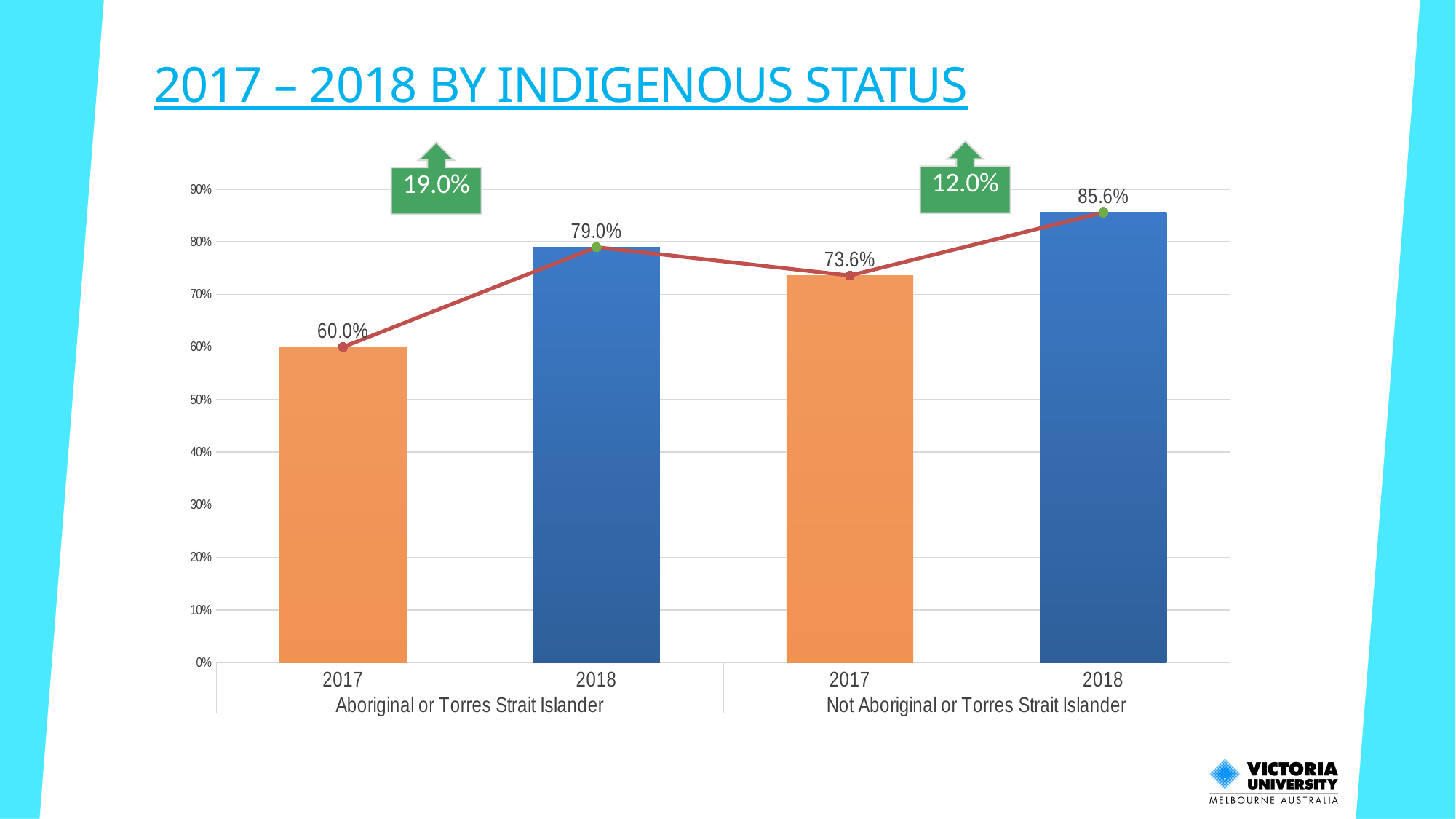
Which bar has the highest value? 2018, Not Aboriginal or Torres Strait Islander Which is larger: the 2018 value for Aboriginal or Torres Strait Islander or the 2017 value for Not Aboriginal or Torres Strait Islander? 2018 Aboriginal or Torres Strait Islander What is the difference between the 2018 and 2017 values for the Not Aboriginal or Torres Strait Islander group? 12.0% What kind of chart is shown on the slide? Bar chart with a line overlay How many bars are plotted on the chart? 4 What is the title of the slide? 2017 – 2018 BY INDIGENOUS STATUS Which bar has the lowest value? 2017, Aboriginal or Torres Strait Islander What is the value for 2017 in the Not Aboriginal or Torres Strait Islander group? 73.6% What is the difference between the 2018 and 2017 values for the Aboriginal or Torres Strait Islander group? 19.0% What is the value for 2017 in the Aboriginal or Torres Strait Islander group? 60.0% What is the value for 2018 in the Aboriginal or Torres Strait Islander group? 79.0% What is the value for 2018 in the Not Aboriginal or Torres Strait Islander group? 85.6%